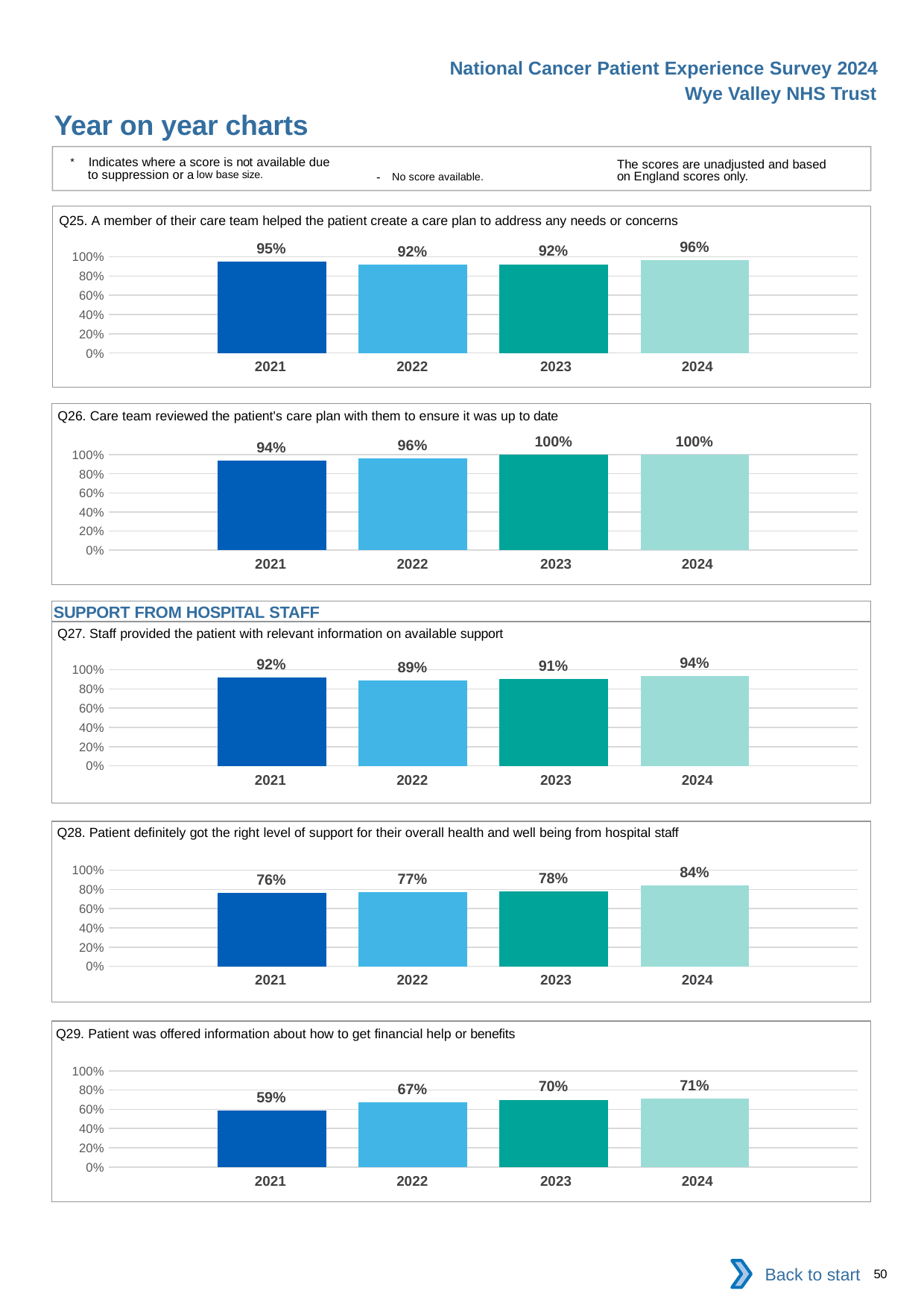
In the Q25 chart, what is the value for 2024? 96% In the Q29 chart, what is the value for 2021? 59% How many bars are in the Q26 chart? 4 In the Q29 chart, what is the difference between the 2023 and 2021 values? 11% In the Q28 chart, is the value for 2021 larger or smaller than the value for 2024? smaller What kind of chart is the Q25 chart? bar chart In the Q26 chart, which year has the lowest value? 2021 In the Q29 chart, do the values rise or fall from 2021 to 2024? rise In the Q27 chart, what is the value for 2023? 91% In the Q26 chart, what is the value for 2023? 100% In the Q28 chart, which year has the highest value? 2024 In the Q27 chart, what is the difference between the 2024 and 2022 values? 5%